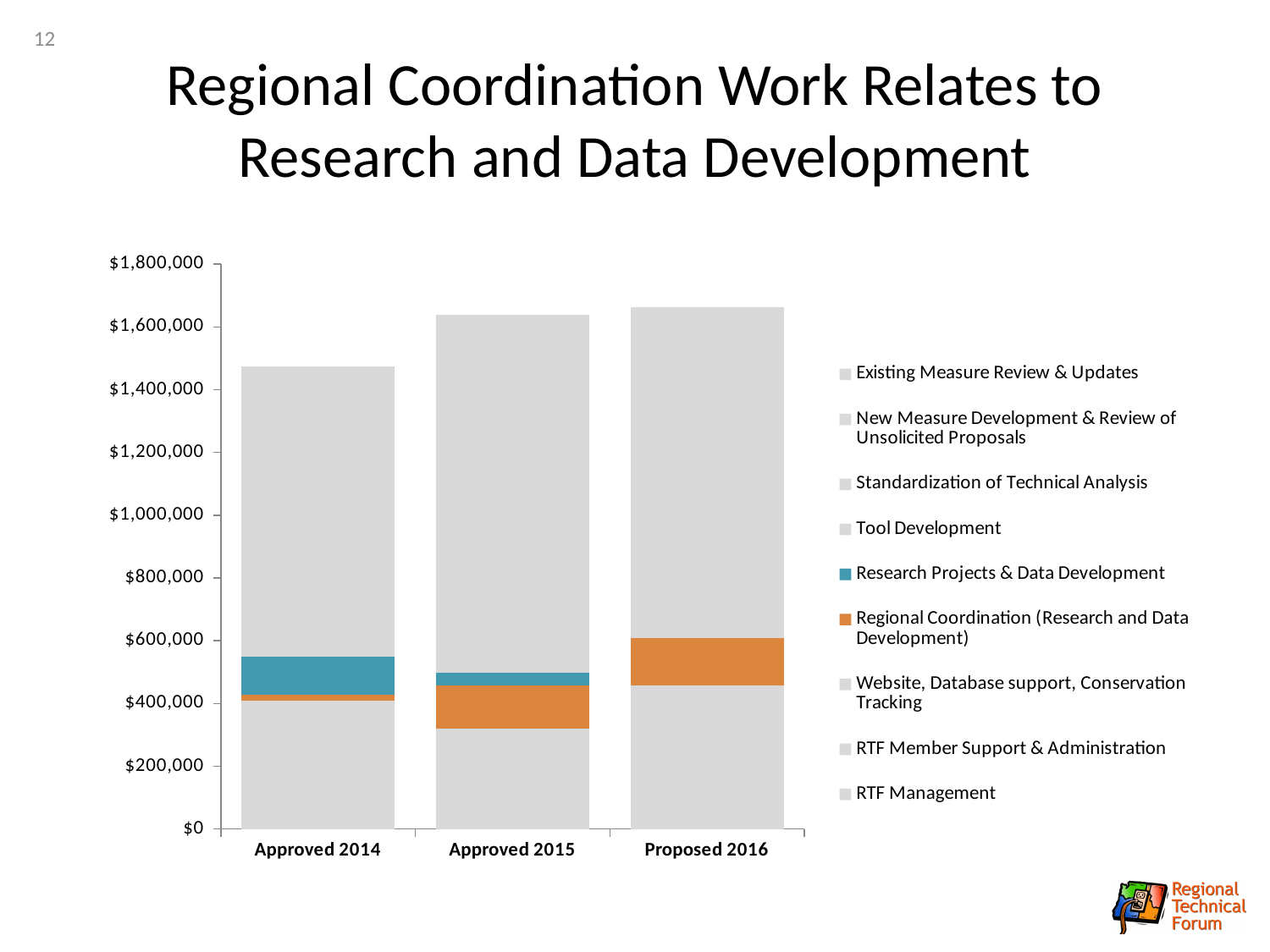
Is the total for Approved 2014 greater or less than $1,400,000? greater What colour represents Regional Coordination (Research and Data Development) in the chart? Orange Is the Regional Coordination (Research and Data Development) segment larger in Approved 2014 or Proposed 2016? Proposed 2016 Which category has the lowest total bar height? Approved 2014 Is the total for Approved 2014 greater or less than $1,600,000? less How many categories (bars) are shown on the x axis? 3 Is the Research Projects & Data Development segment larger in Approved 2014 or Approved 2015? Approved 2014 Do the total bar heights rise or fall from Approved 2014 to Proposed 2016? rise Is the total for Proposed 2016 greater or less than $1,600,000? greater What kind of chart is shown on the slide? Stacked bar chart What is the title of the slide? Regional Coordination Work Relates to Research and Data Development How many series does the legend list? 9